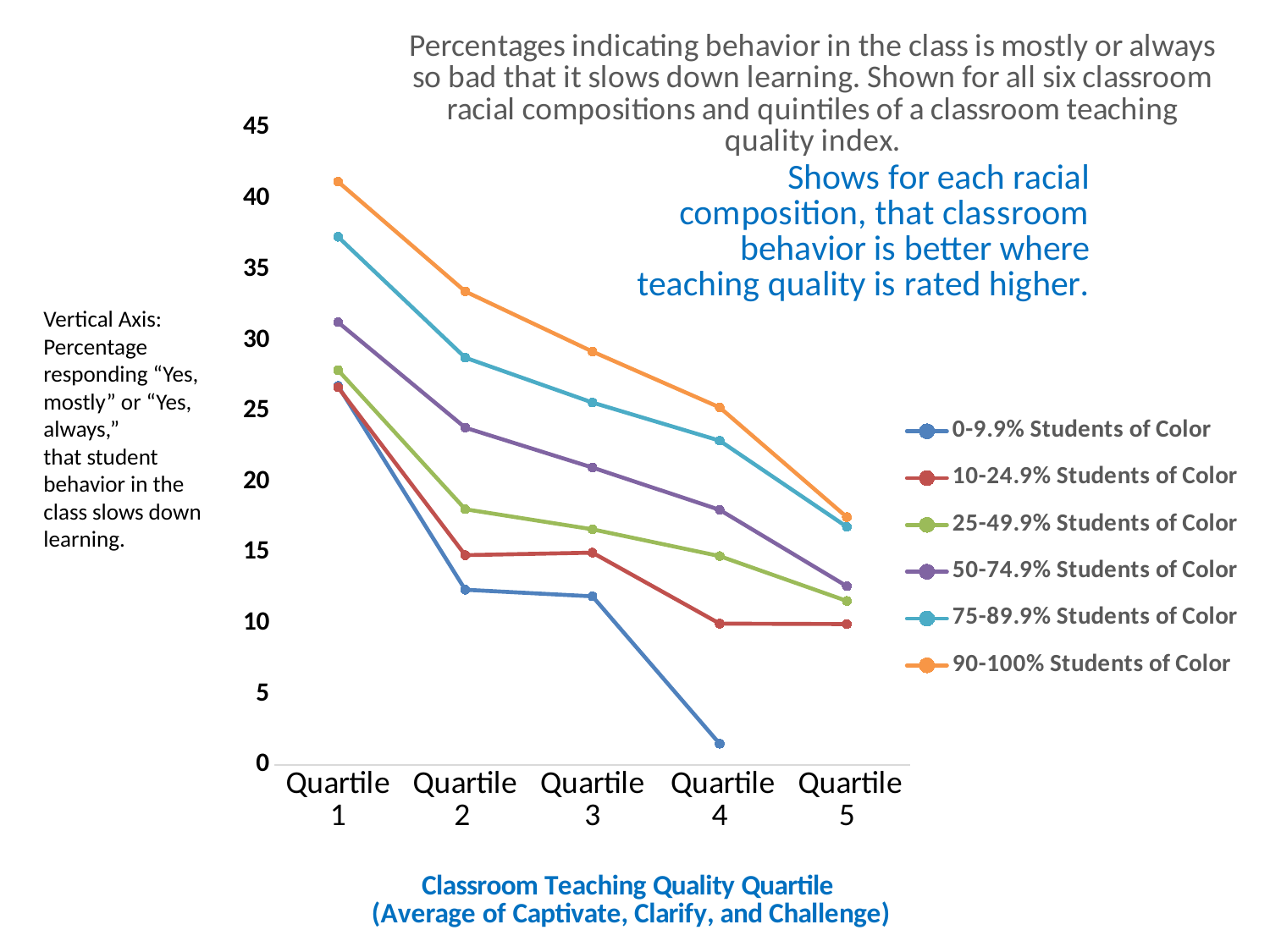
Is the value for 50-74.9% Students of Color at Quartile 2 greater or less than 20? greater What is the title of the x axis? Classroom Teaching Quality Quartile (Average of Captivate, Clarify, and Challenge) How many quartile categories are shown on the x axis? 5 What kind of chart is shown on the slide? line chart How many series does the legend list? 6 Is the value for 0-9.9% Students of Color at Quartile 4 greater or less than 5? less Which series has the lowest value at Quartile 4? 0-9.9% Students of Color Is the value for 75-89.9% Students of Color at Quartile 1 greater or less than 35? greater At Quartile 5, which is larger: the value for 75-89.9% Students of Color or for 25-49.9% Students of Color? 75-89.9% Students of Color Which series has the highest value at Quartile 1? 90-100% Students of Color Do the values for 90-100% Students of Color rise or fall from Quartile 1 to Quartile 5? fall